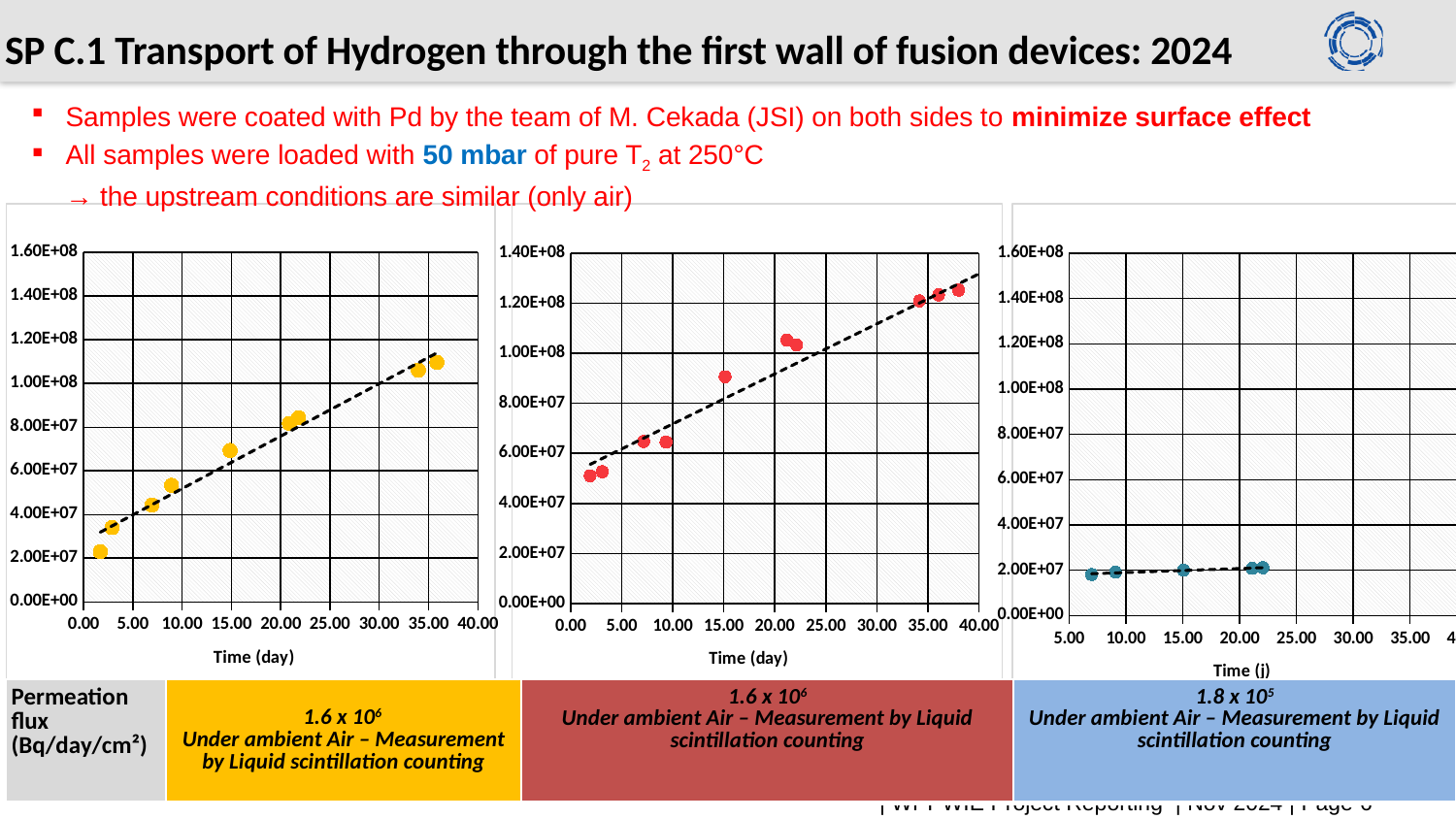
In the left chart, is the value of the first point (at about 2 days) greater or less than 4.00E+07? Less In the right chart, do the plotted values rise steeply or stay roughly flat as time increases? Roughly flat In the left chart, do the plotted values rise or fall as time increases? Rise In the left chart, is the value of the point at about 36 days greater or less than 1.00E+08? Greater What is the highest tick shown on the y-axis of the middle chart? 1.40E+08 In the middle chart, which is larger: the value at about 35 days or the value at about 15 days? The value at about 35 days In the middle chart, is the value of the point at about 15 days greater or less than 8.00E+07? Greater What kind of chart is the left chart on the slide? Scatter chart In the left chart, is the highest point at the smallest or the largest time value? The largest time value In the middle chart, do the plotted values rise or fall as time increases? Rise What is the x-axis label of the left chart? Time (day)